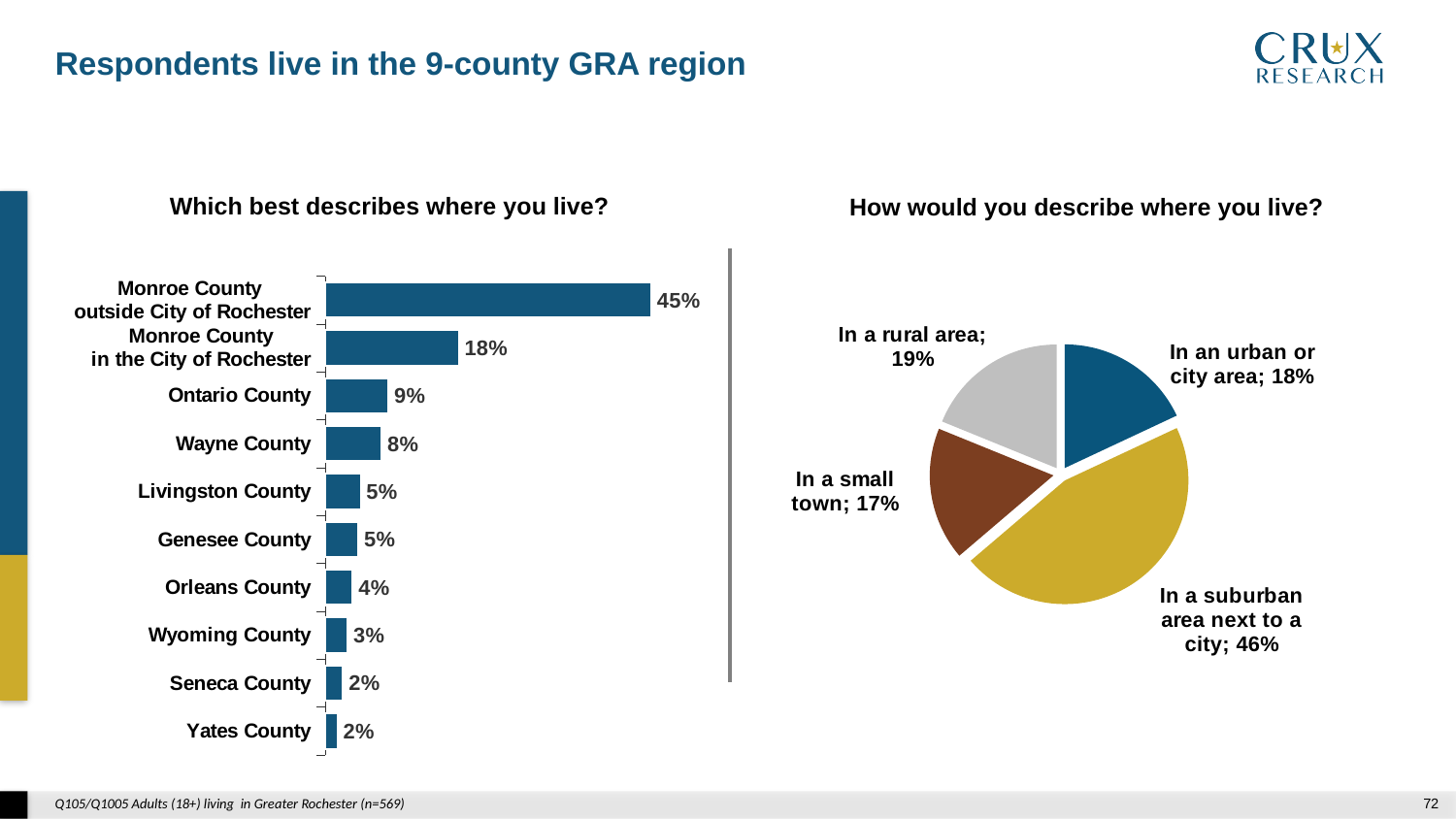
How many categories are shown in the 'Which best describes where you live?' chart? 10 In the 'How would you describe where you live?' chart, which slice is the largest? In a suburban area next to a city In the 'Which best describes where you live?' chart, which is larger, Wayne County or Orleans County? Wayne County In the 'Which best describes where you live?' chart, what is the value for Monroe County in the City of Rochester? 18% In the 'Which best describes where you live?' chart, which category has the highest value? Monroe County outside City of Rochester In the 'How would you describe where you live?' chart, which slice is the smallest? In a small town In the 'How would you describe where you live?' chart, what share of respondents live in a rural area? 19% How many slices does the 'How would you describe where you live?' pie chart have? 4 What kind of chart is the 'How would you describe where you live?' chart? Pie chart In the 'Which best describes where you live?' chart, what is the difference between Monroe County outside City of Rochester and Monroe County in the City of Rochester? 27% What kind of chart is the 'Which best describes where you live?' chart? Bar chart In the 'Which best describes where you live?' chart, what is the value for Ontario County? 9%